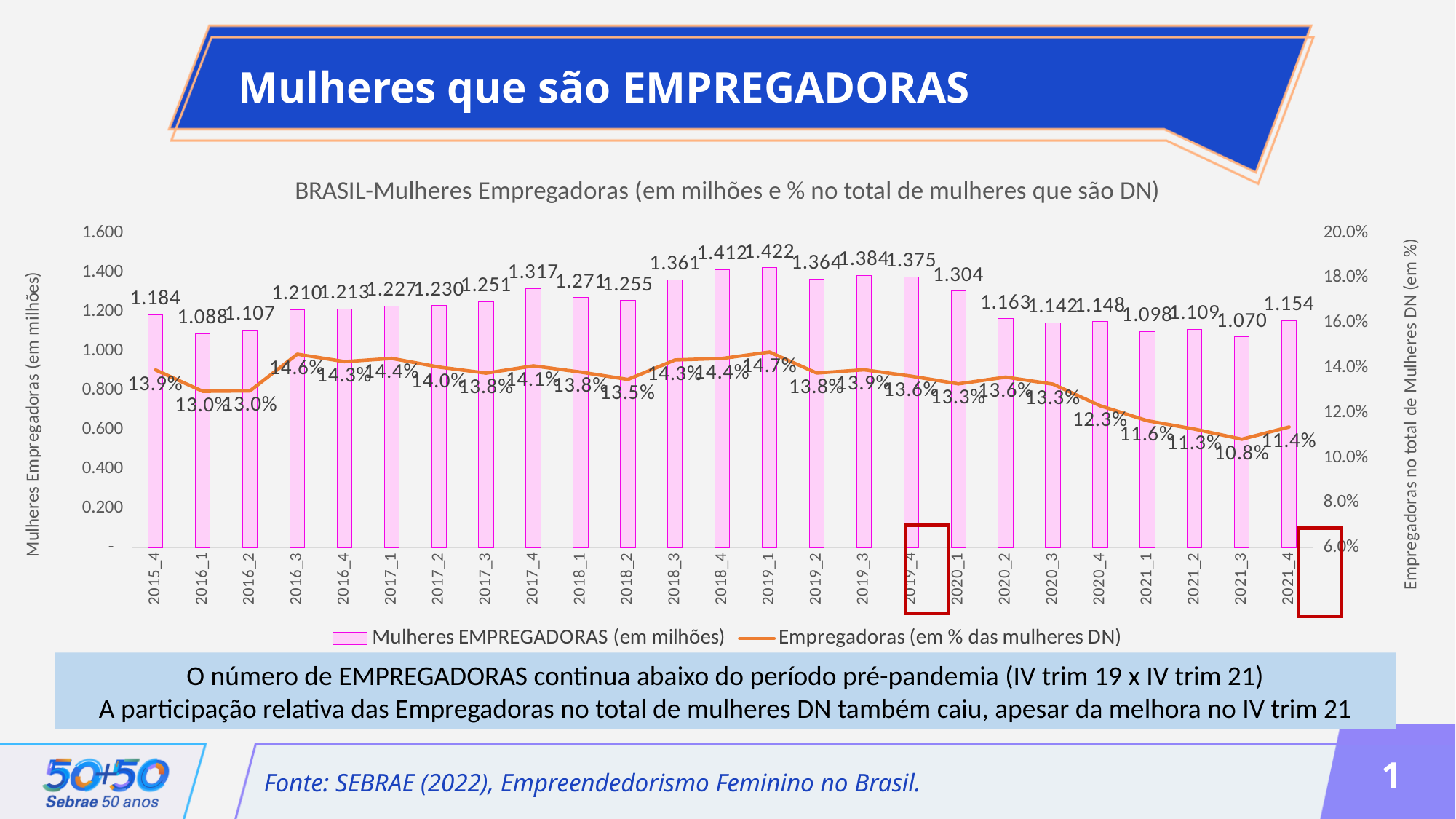
Which quarter has the highest value of Mulheres EMPREGADORAS (em milhões)? 2019_1 What is the difference in Mulheres EMPREGADORAS (em milhões) between 2019_4 and 2021_4? 0.221 What is the value of Mulheres EMPREGADORAS (em milhões) for 2019_1? 1.422 What kind of chart is shown on the slide? Combined bar and line chart How many series does the legend list? 2 Which is larger, the Empregadoras (em % das mulheres DN) value for 2016_3 or for 2020_4? 2016_3 What is the value of Empregadoras (em % das mulheres DN) for 2021_3? 10.8% How many quarters are shown on the x axis? 25 What is the value of Mulheres EMPREGADORAS (em milhões) for 2021_4? 1.154 Does the Empregadoras (em % das mulheres DN) line rise or fall from 2019_1 to 2021_3? Fall Which quarter has the lowest value of Mulheres EMPREGADORAS (em milhões)? 2021_3 Which quarter has the lowest value of Empregadoras (em % das mulheres DN)? 2021_3